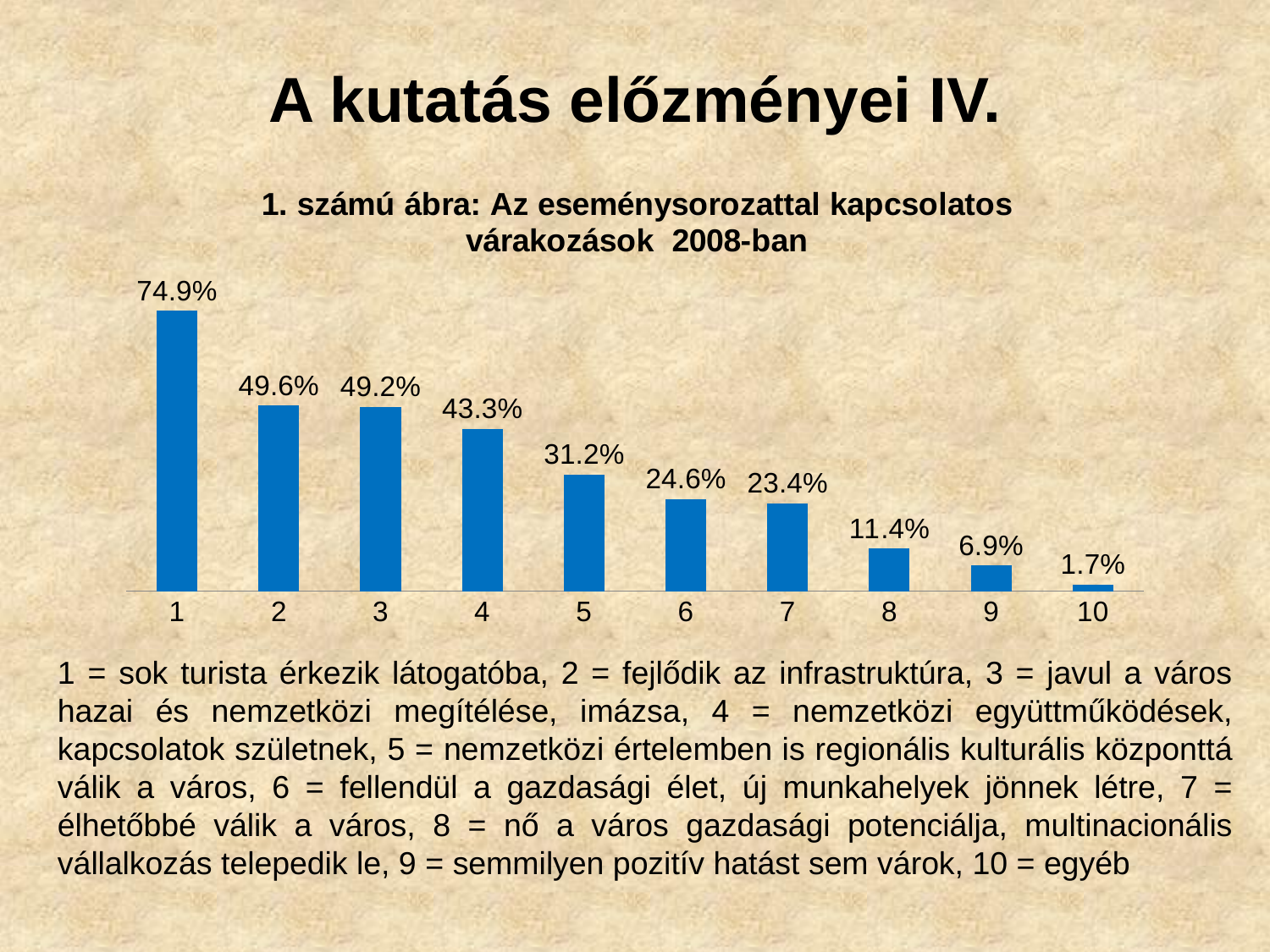
What is the value for category 1? 74.9% Which category has the highest value? 1 What kind of chart is shown on the slide? bar chart What is the value for category 8? 11.4% What is the value for category 5? 31.2% Which category has the lowest value? 10 Do the values rise or fall from category 1 to category 10? fall What is the title of the chart? 1. számú ábra: Az eseménysorozattal kapcsolatos várakozások 2008-ban What is the difference between the values for category 6 and category 7? 1.2% What is the difference between the values for category 1 and category 2? 25.3% How many categories are shown on the x axis? 10 Which is larger, the value for category 4 or the value for category 5? category 4